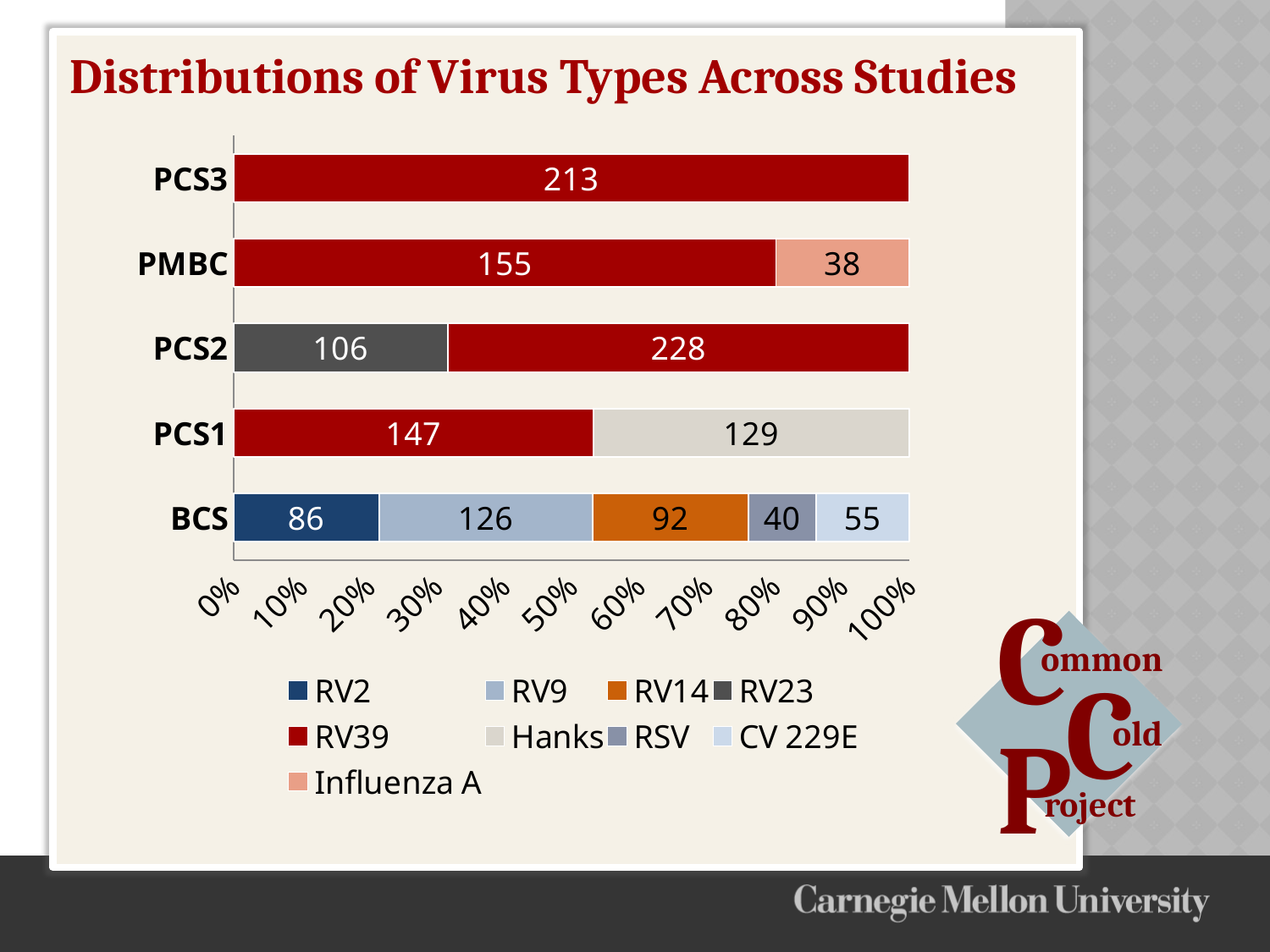
What is the RV39 value for PCS3? 213 What is the difference between the RV39 value and the Hanks value for PCS1? 18 What is the RV23 value for PCS2? 106 What is the RV14 value for BCS? 92 What is the Hanks value for PCS1? 129 What is the Influenza A value for PMBC? 38 Which study has the highest RV39 value? PCS2 How many studies (categories) are shown on the y axis? 5 What kind of chart is shown on the slide? Stacked bar chart Which is larger for BCS, the RV9 value or the RV2 value? RV9 How many series does the legend list? 9 What is the total of all segments in the BCS bar? 399